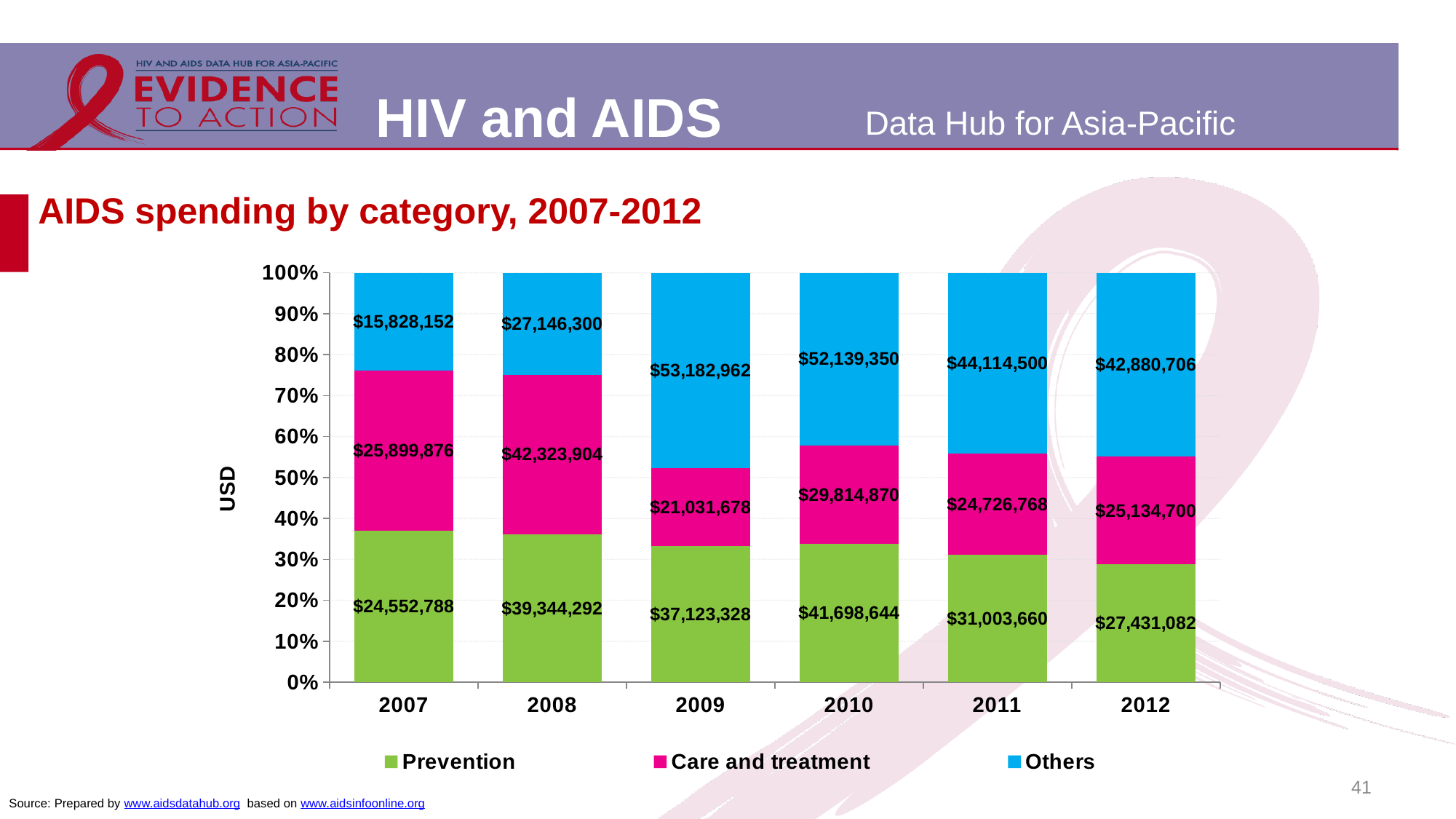
What kind of chart is shown on the slide? Stacked bar chart How many series does the legend list? 3 What is the Prevention spending value shown for 2010? $41,698,644 What is the difference between the Others value and the Prevention value in 2010? $10,440,706 In 2012, which is larger: the Prevention value or the Care and treatment value? Prevention Is the Prevention share of the 2009 bar greater or less than 40%? less What is the Care and treatment spending value shown for 2012? $25,134,700 How many years are shown on the x axis? 6 In which year is the Care and treatment value the highest? 2008 What is the total spending across all three categories in 2007? $66,280,816 In which year is the Others value the lowest? 2007 What is the Others spending value shown for 2009? $53,182,962